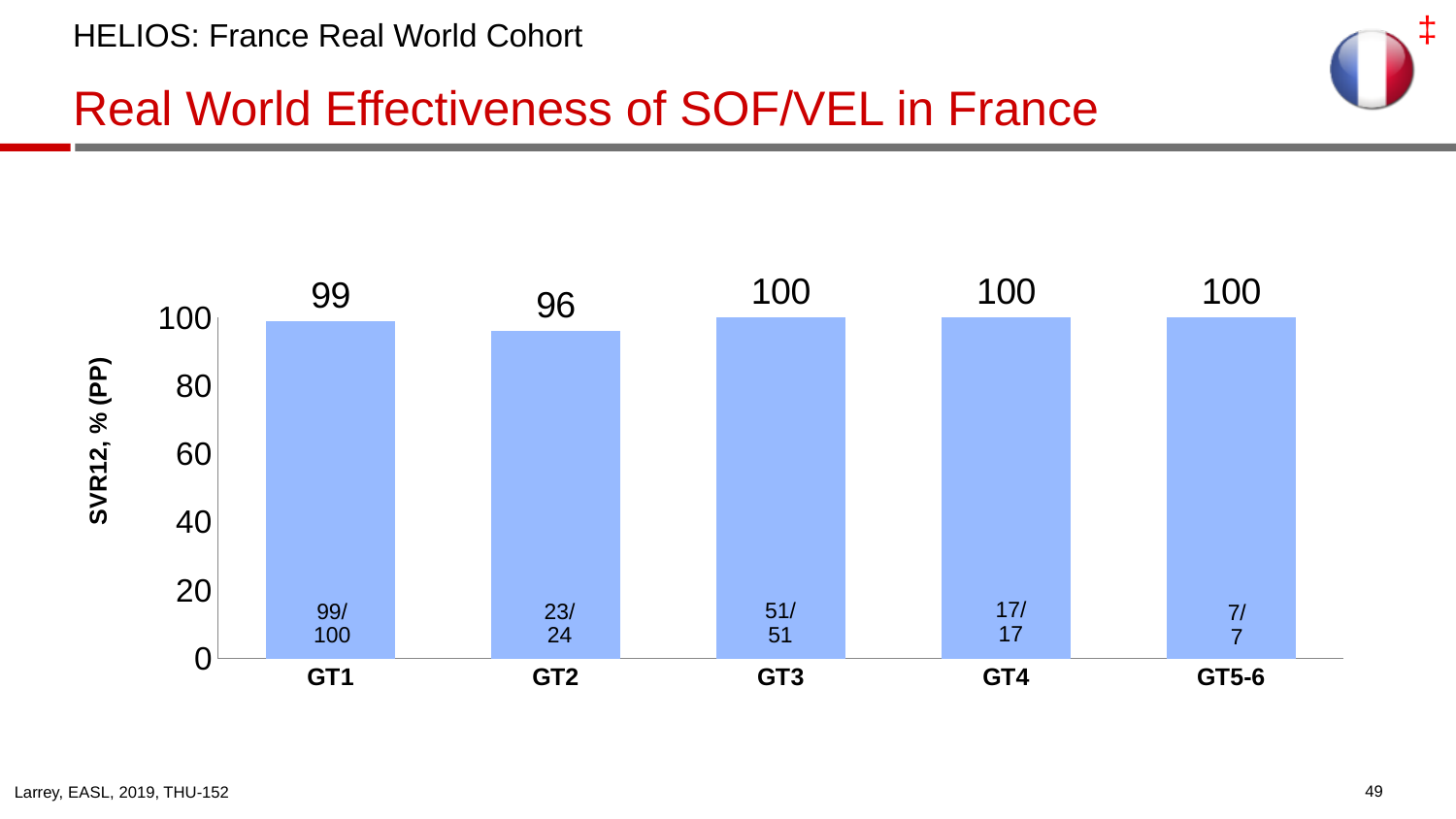
What is the label on the y axis? SVR12, % (PP) What is the SVR12 rate for GT3? 100 What is the SVR12 rate for GT2? 96 Is the SVR12 rate for GT2 greater or less than 80? greater How many genotype categories are shown on the x axis? 5 Which has a higher SVR12 rate, GT1 or GT2? GT1 How many patients achieved SVR12 out of how many in the GT2 group, as labelled on the bar? 23/24 What kind of chart is shown on the slide? Bar chart Which genotype group has the lowest SVR12 rate? GT2 How many genotype groups have an SVR12 rate of 100? 3 What is the difference in SVR12 rate between GT1 and GT2? 3 What is the SVR12 rate for GT1? 99